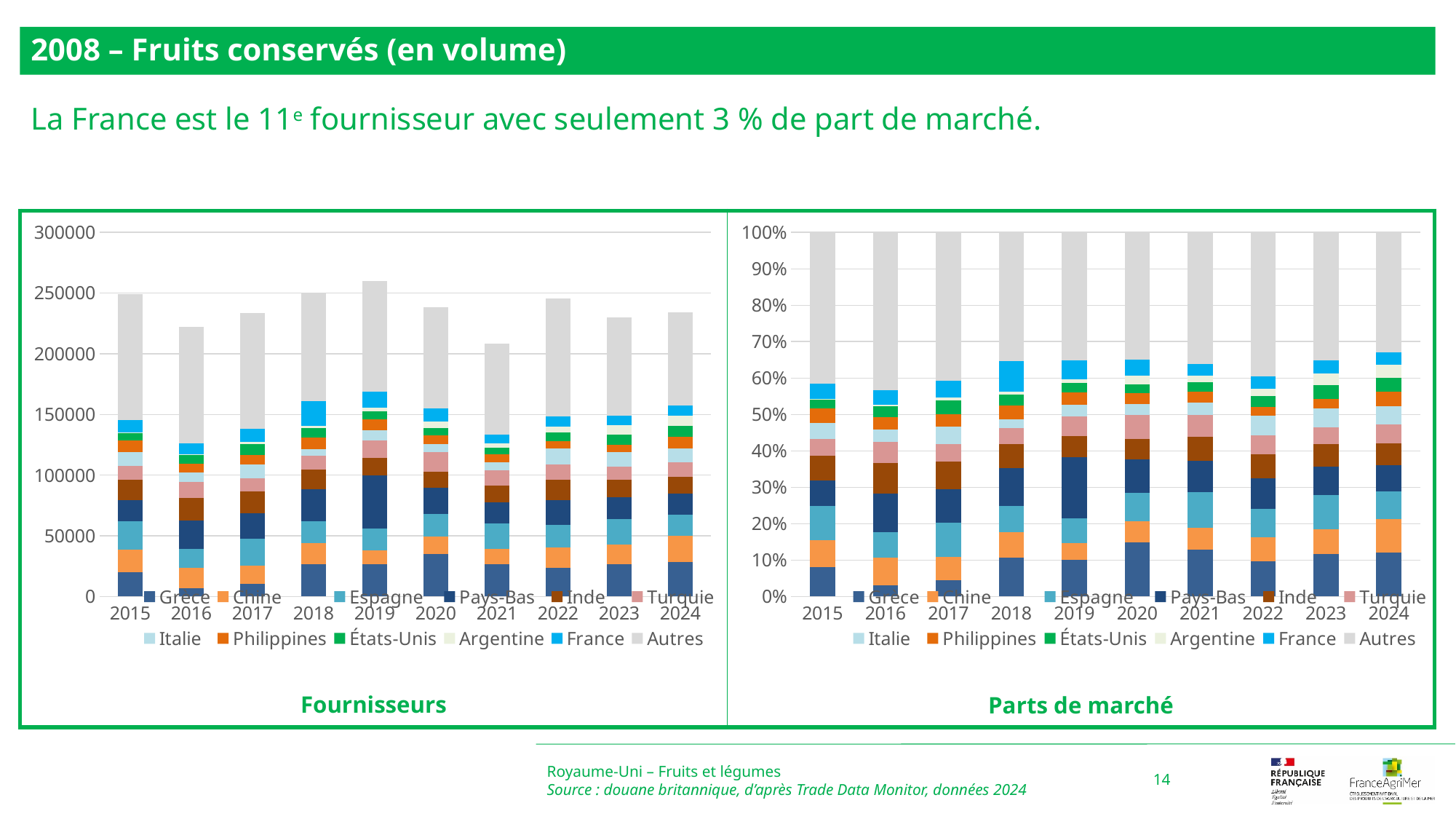
What is the title of the chart on the right side of the slide? Parts de marché In the 'Fournisseurs' chart, is the total bar for 2021 greater or less than 200000? greater How many series does the legend of the 'Parts de marché' chart list? 12 How many years are shown on the x axis of the 'Fournisseurs' chart? 10 In the 'Fournisseurs' chart, is the total bar for 2016 greater or less than 250000? less In the 'Fournisseurs' chart, which year has the tallest total bar? 2019 In the 'Fournisseurs' chart, which year has the shortest total bar? 2021 In the 'Fournisseurs' chart, is the total bar for 2019 greater or less than 250000? greater In the 'Fournisseurs' chart, which total bar is taller, 2019 or 2021? 2019 What kind of chart is the 'Fournisseurs' chart on the left? stacked bar chart